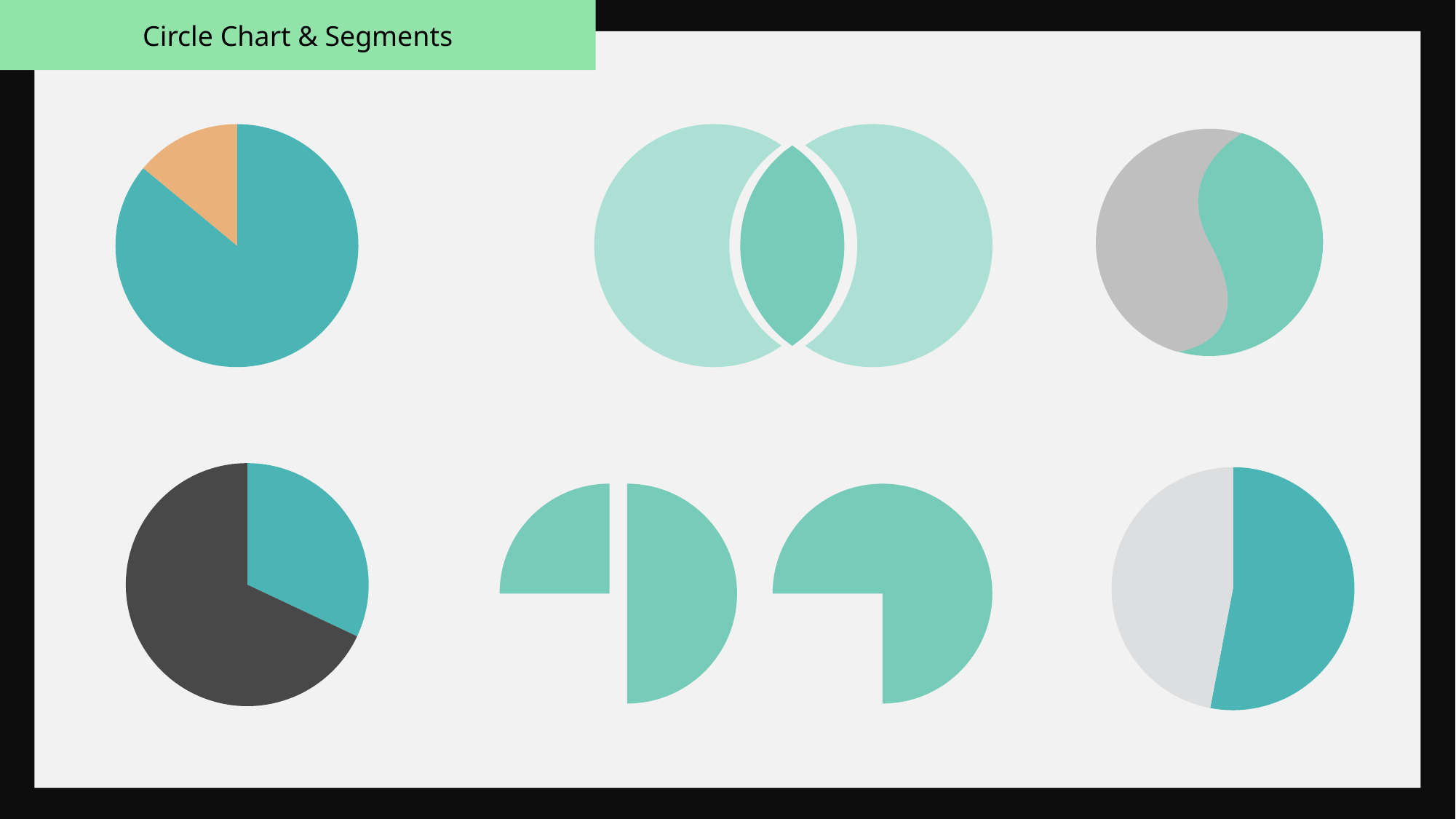
What is the title of the slide? Circle Chart & Segments In the bottom-left pie chart, which slice is larger, the dark grey slice or the teal slice? the dark grey slice How many slices does the top-left pie chart have? 2 What colour is the smaller slice in the top-left pie chart? orange How many slices does the bottom-left pie chart have? 2 In the top-left pie chart, which slice is larger, the teal slice or the orange slice? the teal slice What kind of chart is the top-left chart? pie chart